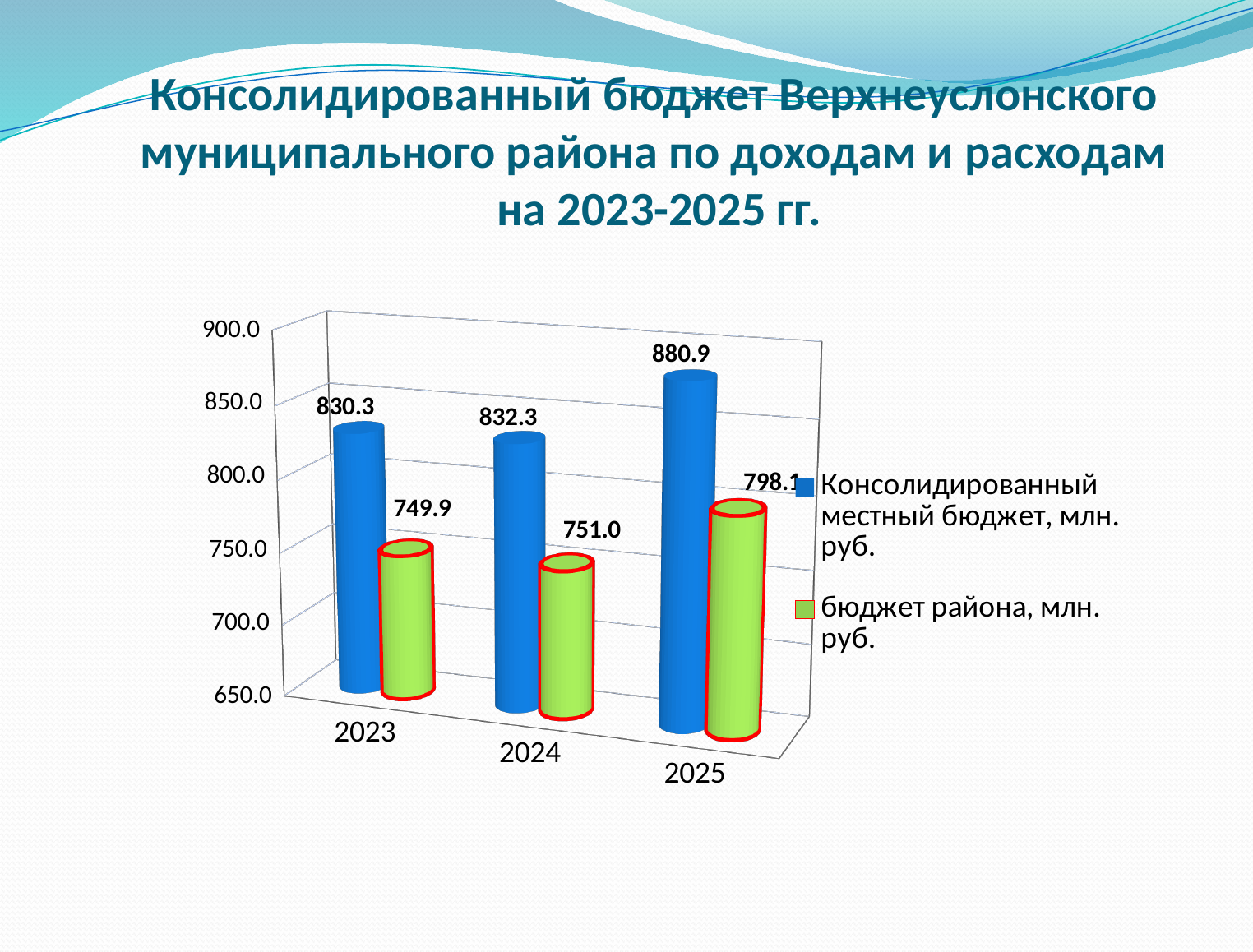
In which year is the consolidated local budget the highest? 2025 What is the value of the district budget (бюджет района) for 2024? 751.0 In which year is the district budget the lowest? 2023 By how much does the consolidated local budget in 2025 exceed that of 2024? 48.6 How many years are shown on the x axis? 3 What kind of chart is shown on the slide? Bar chart How many series does the legend list? 2 Does the district budget rise or fall from 2023 to 2025? Rise What is the value of the district budget (бюджет района) for 2025? 798.1 What is the difference between the consolidated local budget and the district budget in 2025? 82.8 What is the value of the consolidated local budget (Консолидированный местный бюджет) for 2023? 830.3 Which is larger in 2024: the consolidated local budget or the district budget? Консолидированный местный бюджет